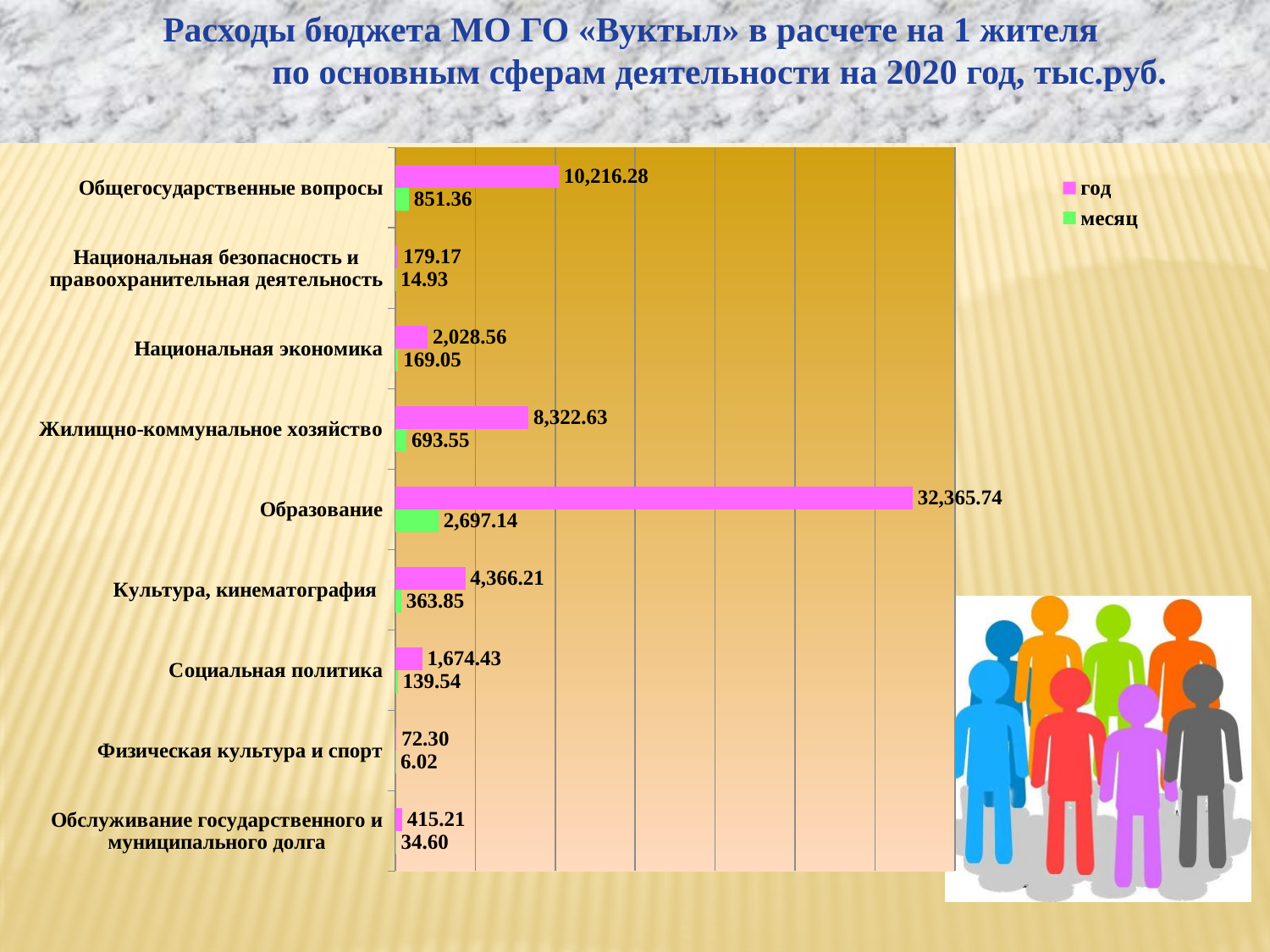
What is the value for "год" for Культура, кинематография? 4,366.21 What kind of chart is shown on the slide? Bar chart Which category has the highest value for "год"? Образование Which category has the lowest value for "месяц"? Физическая культура и спорт How many series does the legend list? 2 Which is larger: the "год" value for Национальная экономика or for Социальная политика? Национальная экономика How many categories are shown on the chart? 9 What is the difference between the "год" values for Общегосударственные вопросы and Жилищно-коммунальное хозяйство? 1,893.65 Which colour represents the "месяц" series? Green What is the value for "месяц" for Жилищно-коммунальное хозяйство? 693.55 What is the value for "год" for Образование? 32,365.74 What is the value for "месяц" for Физическая культура и спорт? 6.02